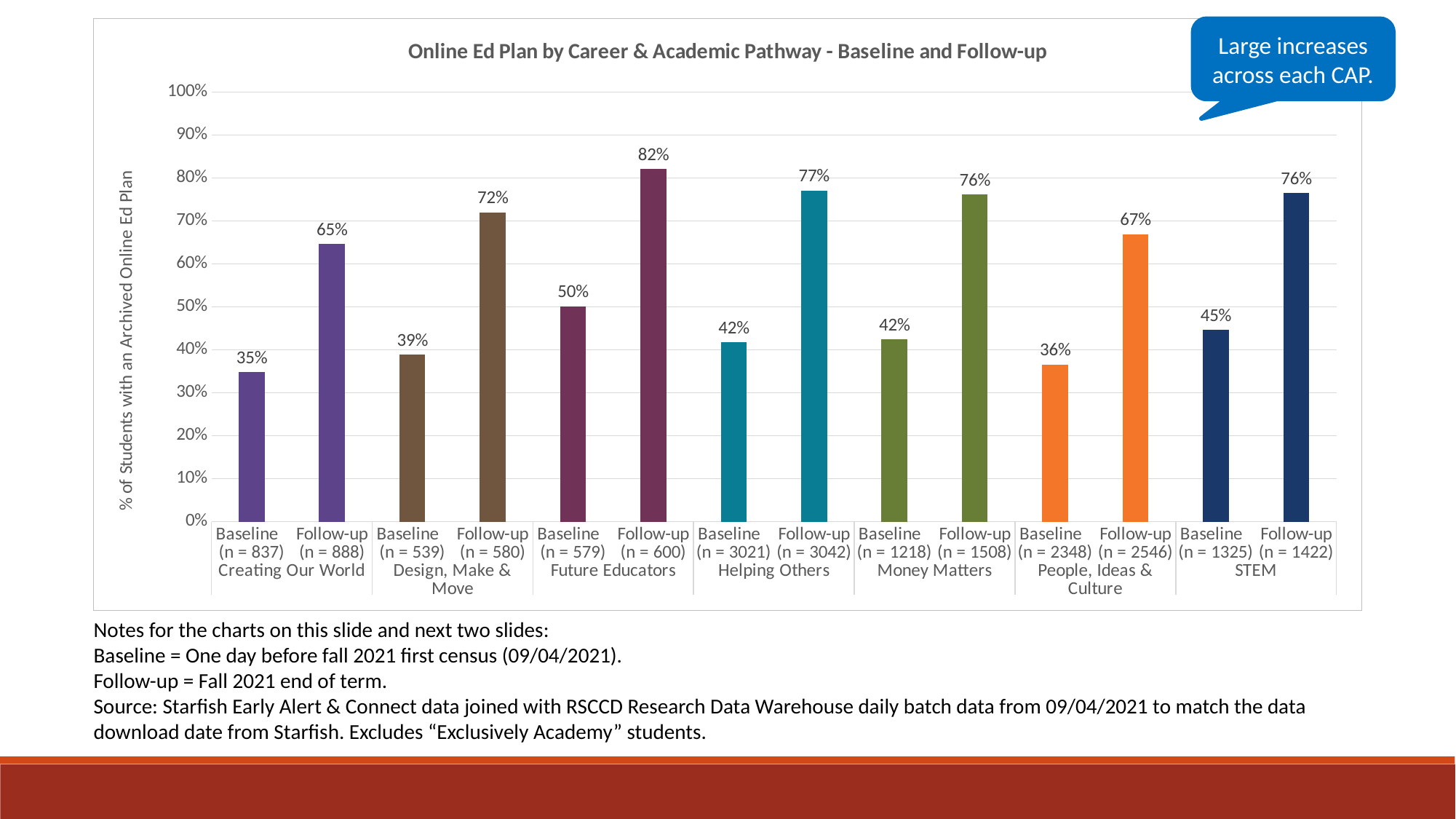
What is the title of the chart? Online Ed Plan by Career & Academic Pathway - Baseline and Follow-up Which pathway has the highest Follow-up value? Future Educators What is the Follow-up value for STEM? 76% What is the sample size (n) for the Follow-up bar for Helping Others? 3042 How many Career & Academic Pathways are shown on the chart? 7 Which pathway has the lowest Baseline value? Creating Our World Which is larger: the Follow-up value for Helping Others or the Follow-up value for People, Ideas & Culture? Helping Others What is the Follow-up value for Future Educators? 82% What kind of chart is shown on the slide? Bar chart What is the difference between the Follow-up and Baseline values for Design, Make & Move? 33% What is the difference between the Follow-up and Baseline values for Money Matters? 34% What is the Baseline value for People, Ideas & Culture? 36%